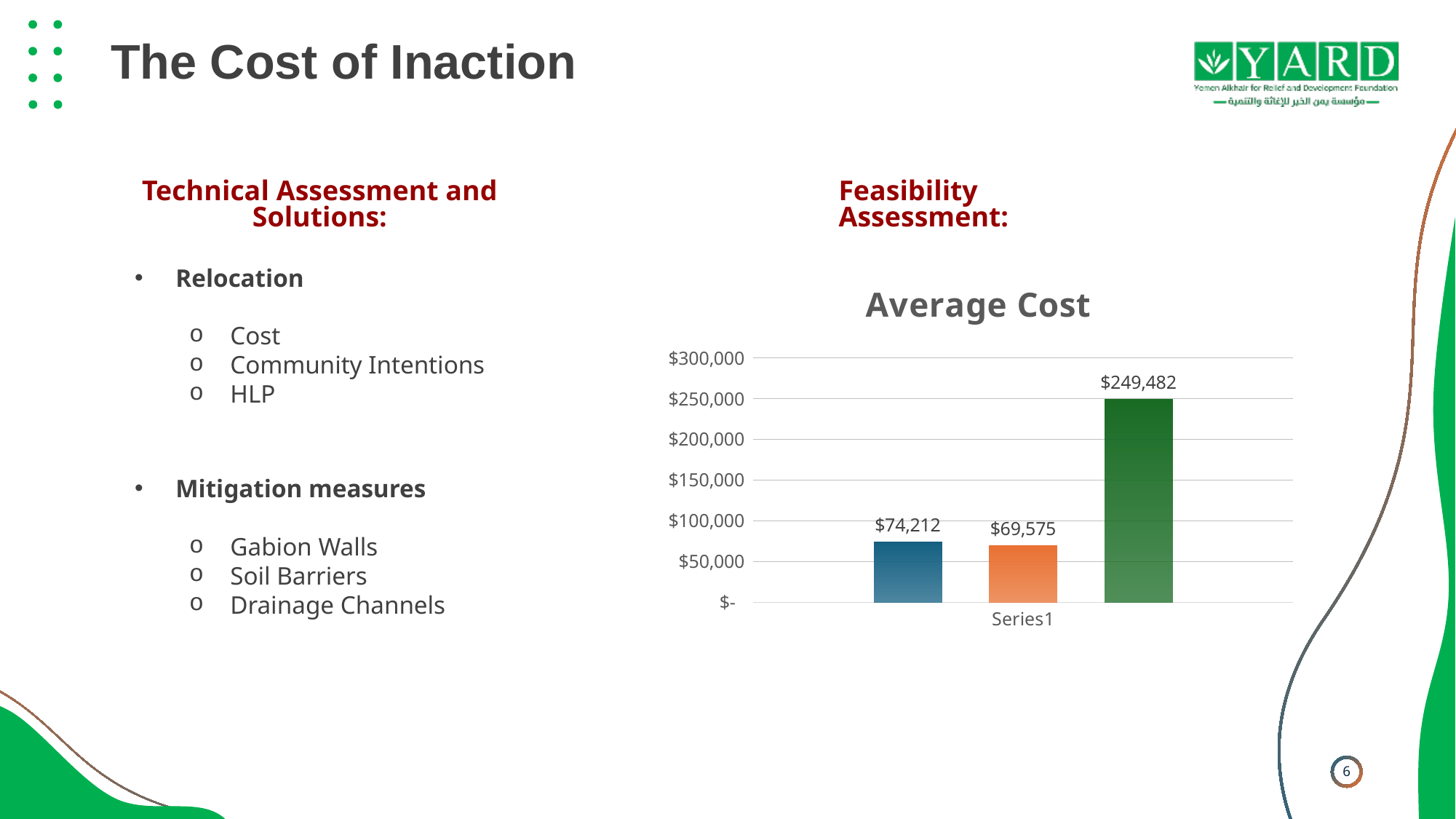
What category label appears on the x axis of the "Average Cost" chart? Series1 Is the value of the green bar in the "Average Cost" chart greater or less than $200,000? greater What type of chart is shown under "Average Cost"? bar chart What is the value shown on the green (rightmost) bar in the "Average Cost" chart? $249,482 What is the difference between the green bar ($249,482) and the blue bar ($74,212) in the "Average Cost" chart? $175,270 What is the title of the chart on the slide? Average Cost What is the value shown on the blue (leftmost) bar in the "Average Cost" chart? $74,212 What is the value shown on the orange (middle) bar in the "Average Cost" chart? $69,575 Which bar has the highest value in the "Average Cost" chart? the green (rightmost) bar, $249,482 Which bar has the lowest value in the "Average Cost" chart? the orange (middle) bar, $69,575 How many bars are plotted in the "Average Cost" chart? 3 What is the difference between the blue bar ($74,212) and the orange bar ($69,575) in the "Average Cost" chart? $4,637